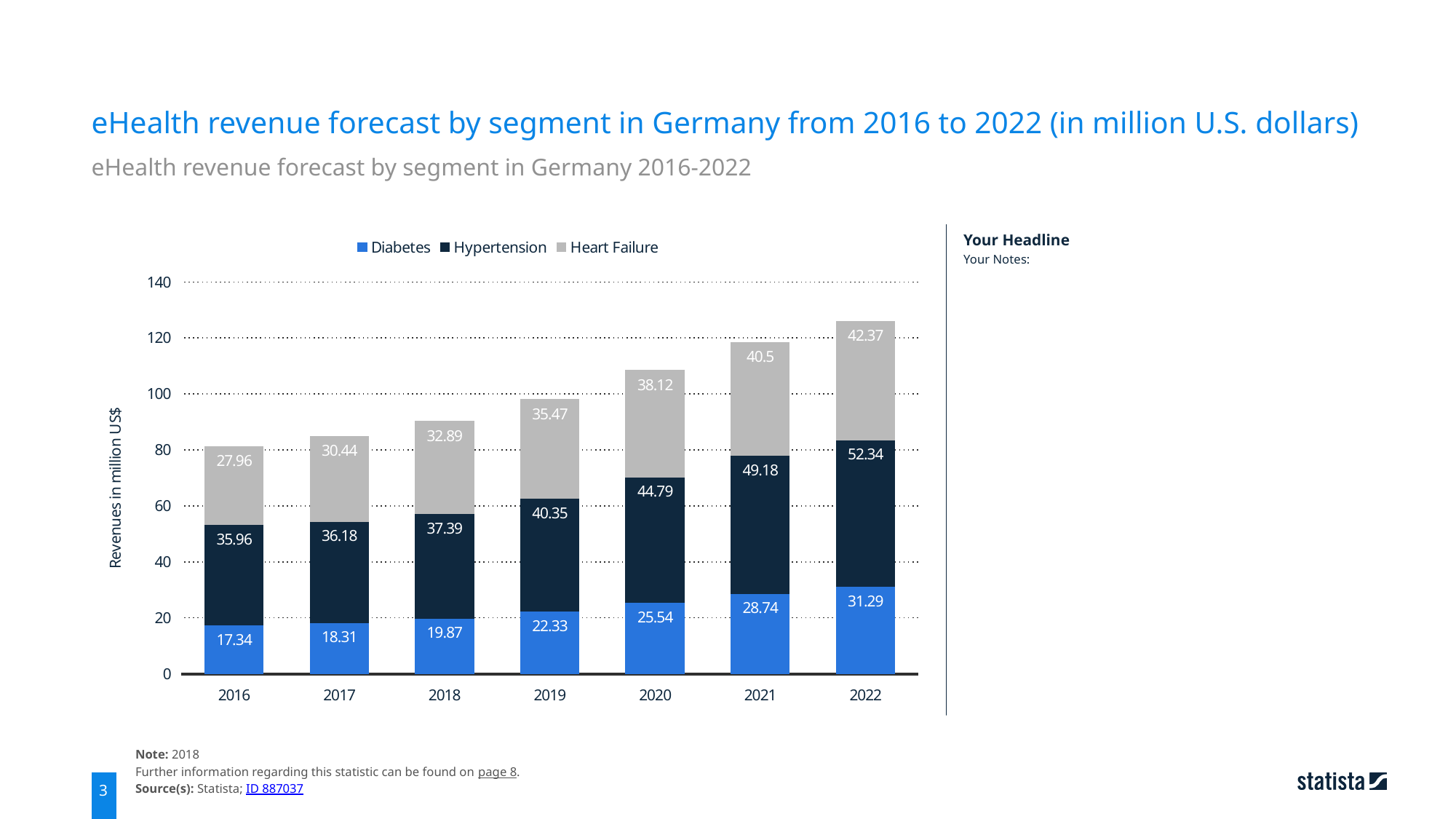
In which year is the Hypertension revenue forecast highest? 2022 Which is larger in 2020: the Hypertension forecast or the Heart Failure forecast? Hypertension What kind of chart is shown on the slide? Stacked bar chart What is the total of the stacked bar for 2022? 126 In which year is the Diabetes revenue forecast lowest? 2016 How many years are shown on the x axis? 7 What is the Hypertension revenue forecast for 2017? 36.18 What is the difference between the Heart Failure forecast in 2022 and in 2016? 14.41 What is the Heart Failure revenue forecast for 2021? 40.5 Is the total stacked bar for 2018 greater or less than 100? less How many series does the legend list? 3 What is the Diabetes revenue forecast for 2019? 22.33